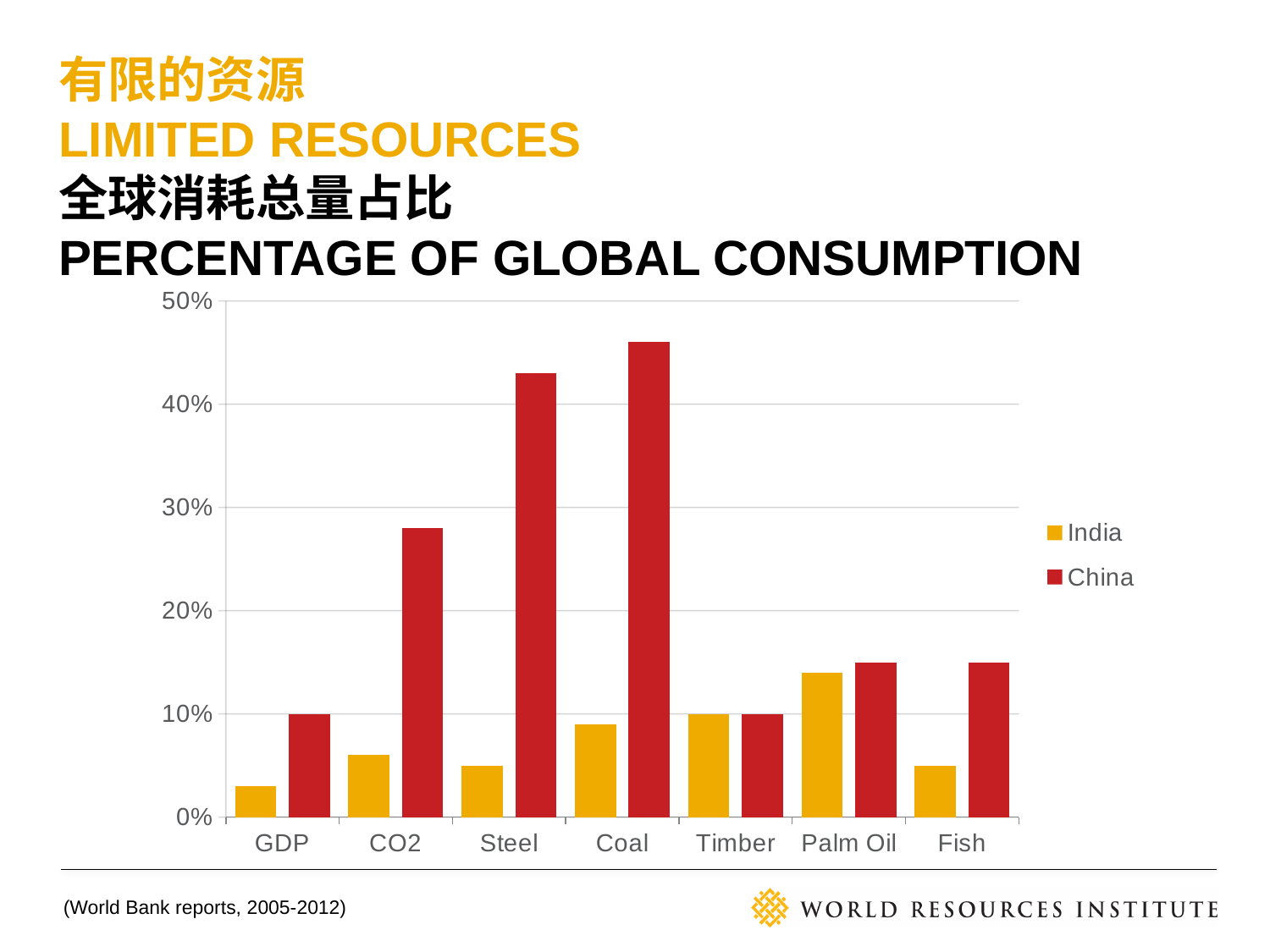
Which is larger for Fish: India or China? China Is the value for China in Coal greater or less than 40%? greater Is the value for India in Steel greater or less than 10%? less Which colour represents China in the chart? red What kind of chart is shown on the slide? bar chart How many categories are shown on the x axis? 7 For which category is India's percentage of global consumption lowest? GDP Which is larger for China: Steel or CO2? Steel How many series does the legend list? 2 For which category is China's percentage of global consumption highest? Coal Is the value for India in Palm Oil greater or less than 10%? greater